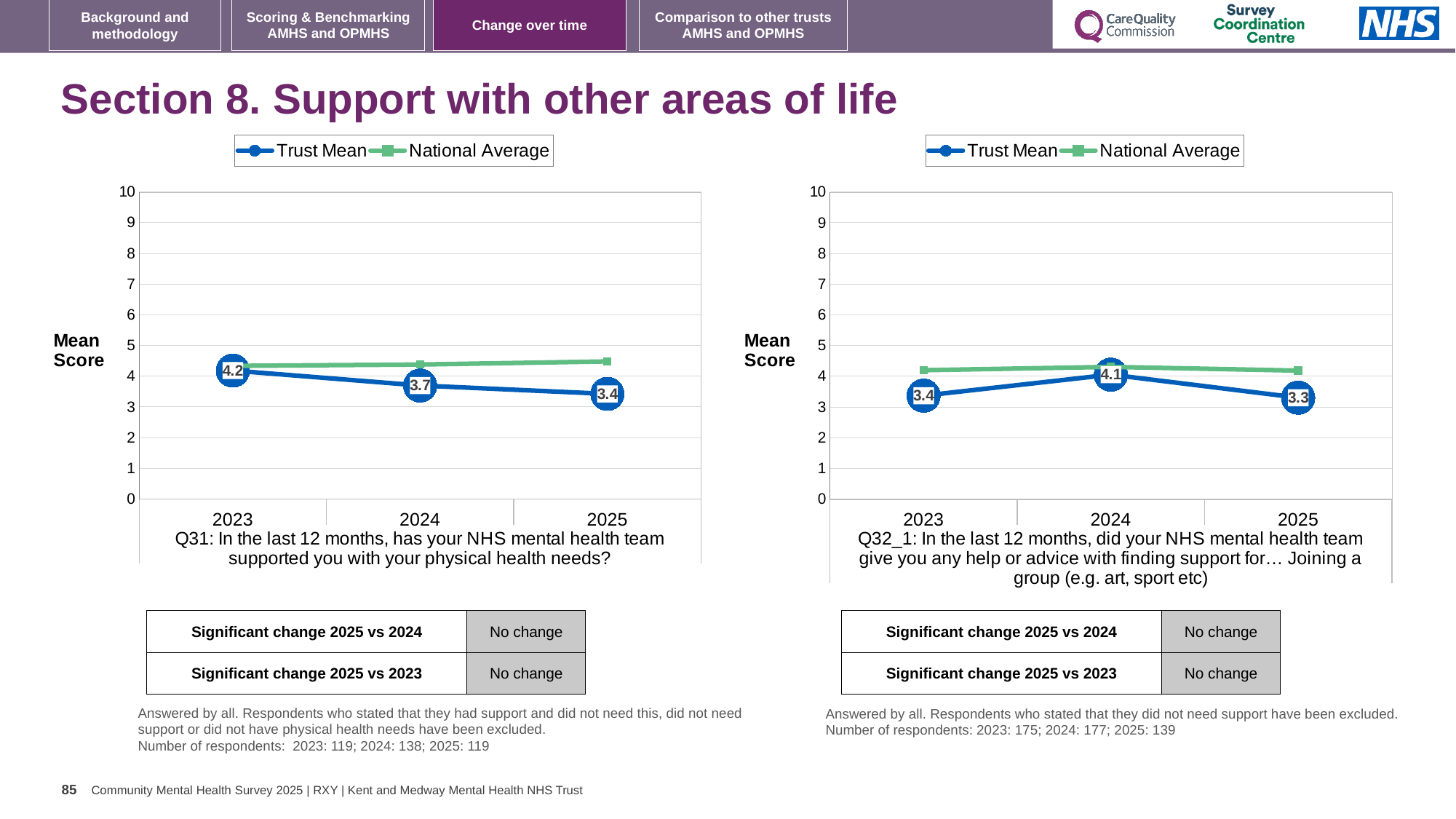
In the Q32_1 chart (right), what is the Trust Mean for 2024? 4.1 In the Q31 chart (left), which year has the highest Trust Mean? 2023 In the Q31 chart (left), what is the Trust Mean for 2025? 3.4 In the Q31 chart (left), is the National Average for 2025 greater or less than 4? greater How many series does the legend of the Q32_1 chart (right) list? 2 What kind of chart is the Q31 chart (left)? line chart In the Q32_1 chart (right), which year has the lowest Trust Mean? 2025 In the Q32_1 chart (right), what is the Trust Mean for 2025? 3.3 In the Q31 chart (left), does the Trust Mean rise or fall from 2023 to 2025? fall In the Q31 chart (left), what is the difference between the Trust Mean in 2023 and in 2025? 0.8 In the Q31 chart (left), what is the Trust Mean for 2023? 4.2 In the Q32_1 chart (right), what is the difference between the Trust Mean in 2024 and in 2023? 0.7